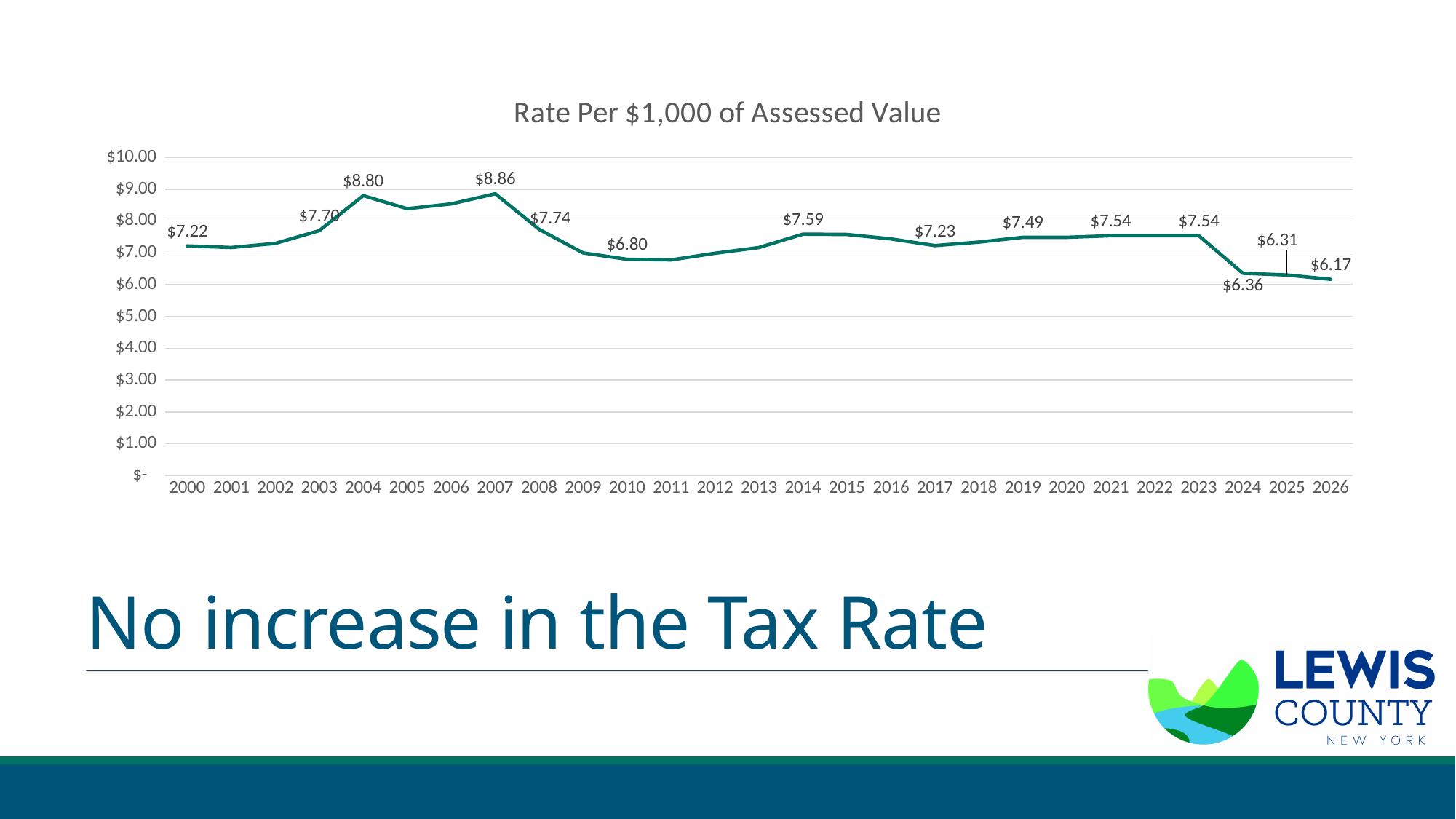
Which year has the lowest rate per $1,000 of assessed value? 2026 What is the title of the chart? Rate Per $1,000 of Assessed Value Which is larger, the rate in 2004 or the rate in 2010? 2004 What is the difference between the rate in 2023 and the rate in 2024? $1.18 What type of chart is shown on the slide? line chart What is the difference between the rate in 2007 and the rate in 2008? $1.12 How many years are shown on the x axis? 27 Is the rate for 2005 greater or less than $8.00? greater Which year has the highest rate per $1,000 of assessed value? 2007 What is the rate per $1,000 of assessed value in 2000? $7.22 What is the rate per $1,000 of assessed value in 2007? $8.86 What is the rate per $1,000 of assessed value in 2026? $6.17